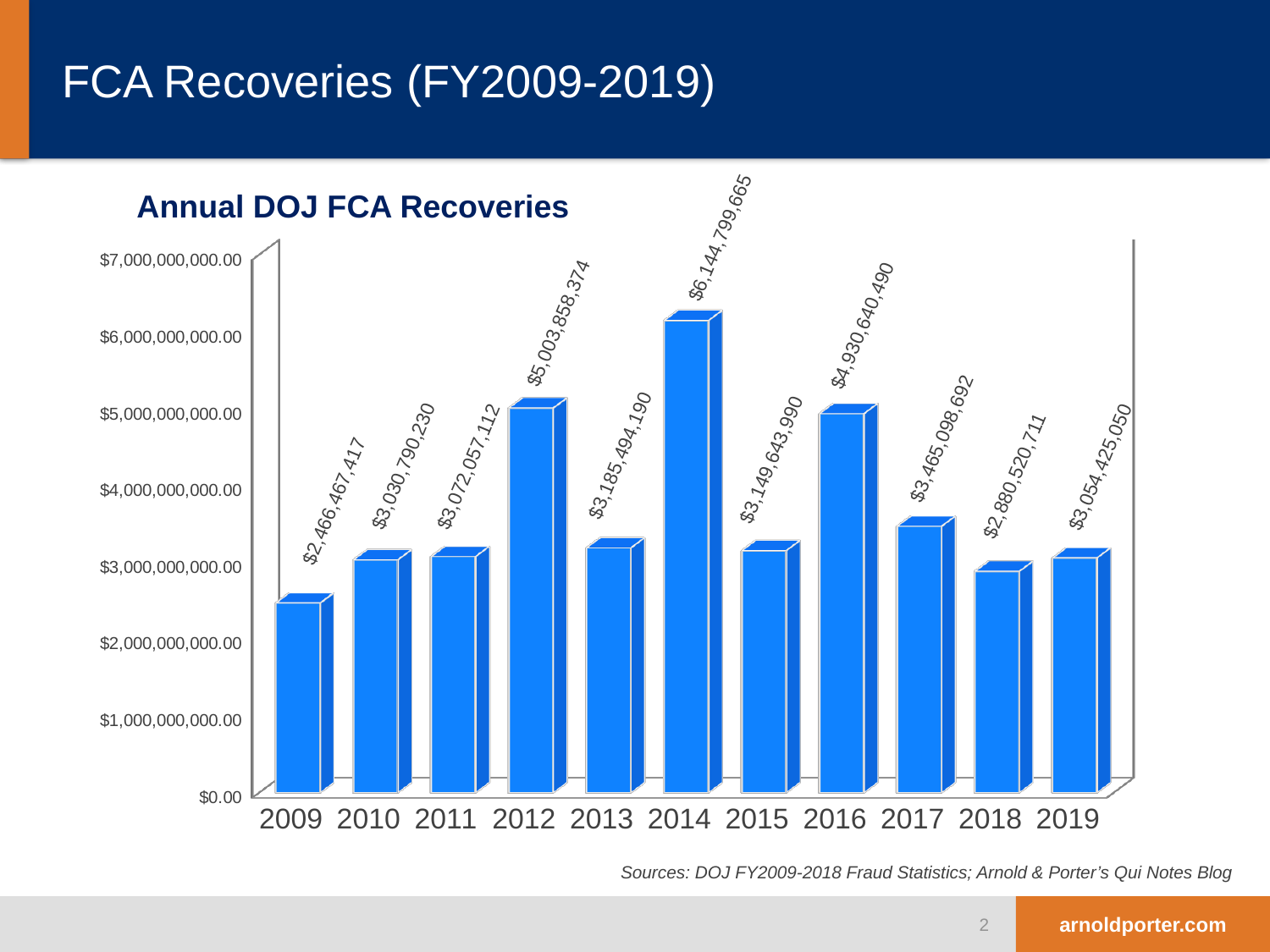
What is the value for 2019? $3,054,425,050 Which year has the highest recoveries? 2014 What is the value for 2009? $2,466,467,417 What is the difference between the 2014 and 2012 values? $1,140,941,291 What is the title of the chart? Annual DOJ FCA Recoveries What is the difference between the 2019 and 2018 values? $173,904,339 Do the values rise or fall from 2016 to 2018? Fall Which is larger, the value for 2012 or the value for 2016? 2012 Which year has the lowest recoveries? 2009 How many years are plotted in the chart? 11 What is the value for 2014? $6,144,799,665 What type of chart is shown on the slide? Bar chart